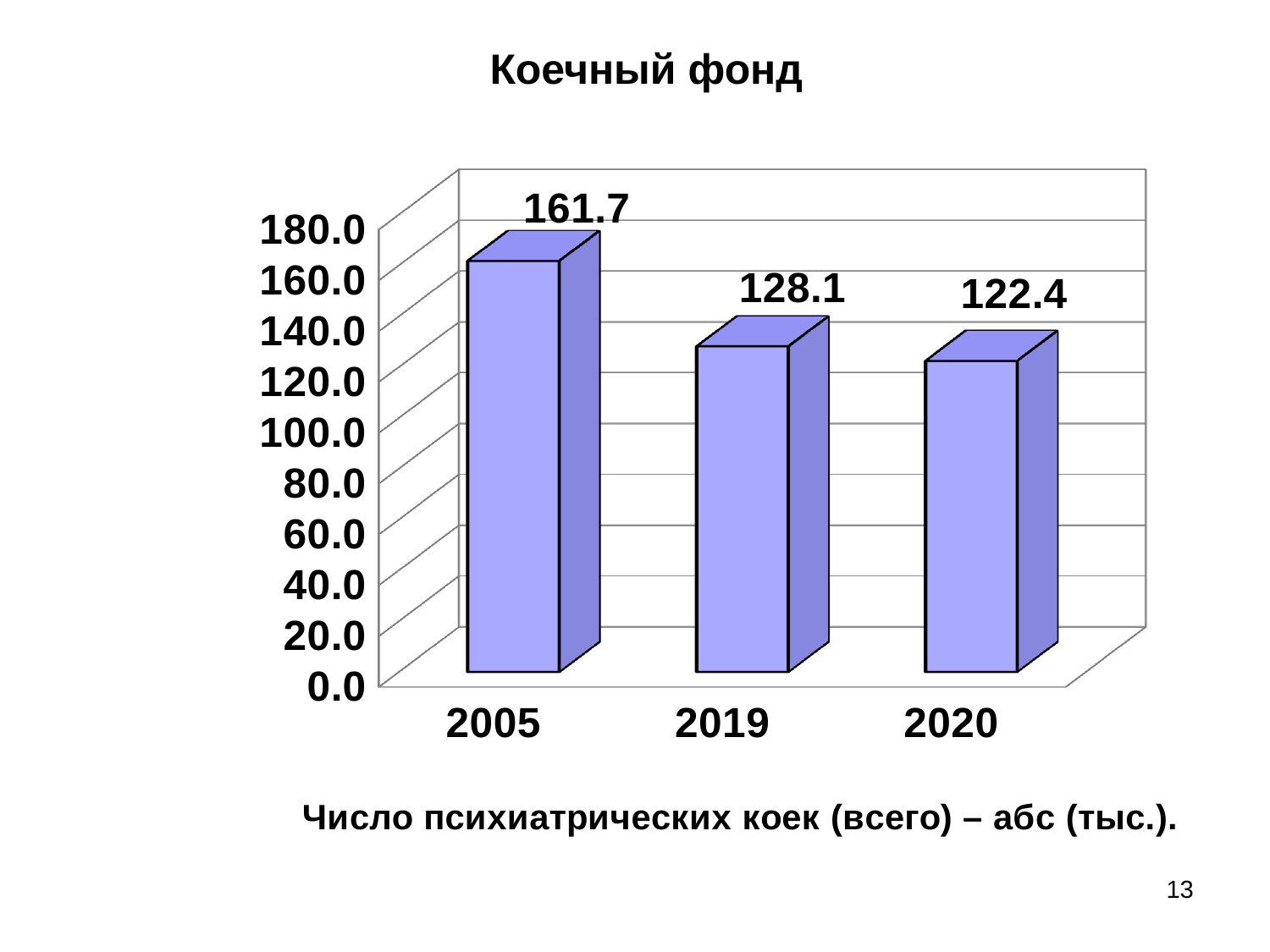
Is the value for 2005 greater or less than 140.0? greater What is the difference between the values for 2005 and 2020? 39.3 Do the values rise or fall from 2005 to 2020? fall What is the difference between the values for 2019 and 2020? 5.7 What is the value for 2020? 122.4 Which year has the lowest value? 2020 What is the value for 2019? 128.1 What kind of chart is shown on the slide? bar chart What is the value for 2005? 161.7 Which year has the highest value? 2005 How many years are shown on the x axis? 3 Which is larger, the value for 2019 or the value for 2020? 2019